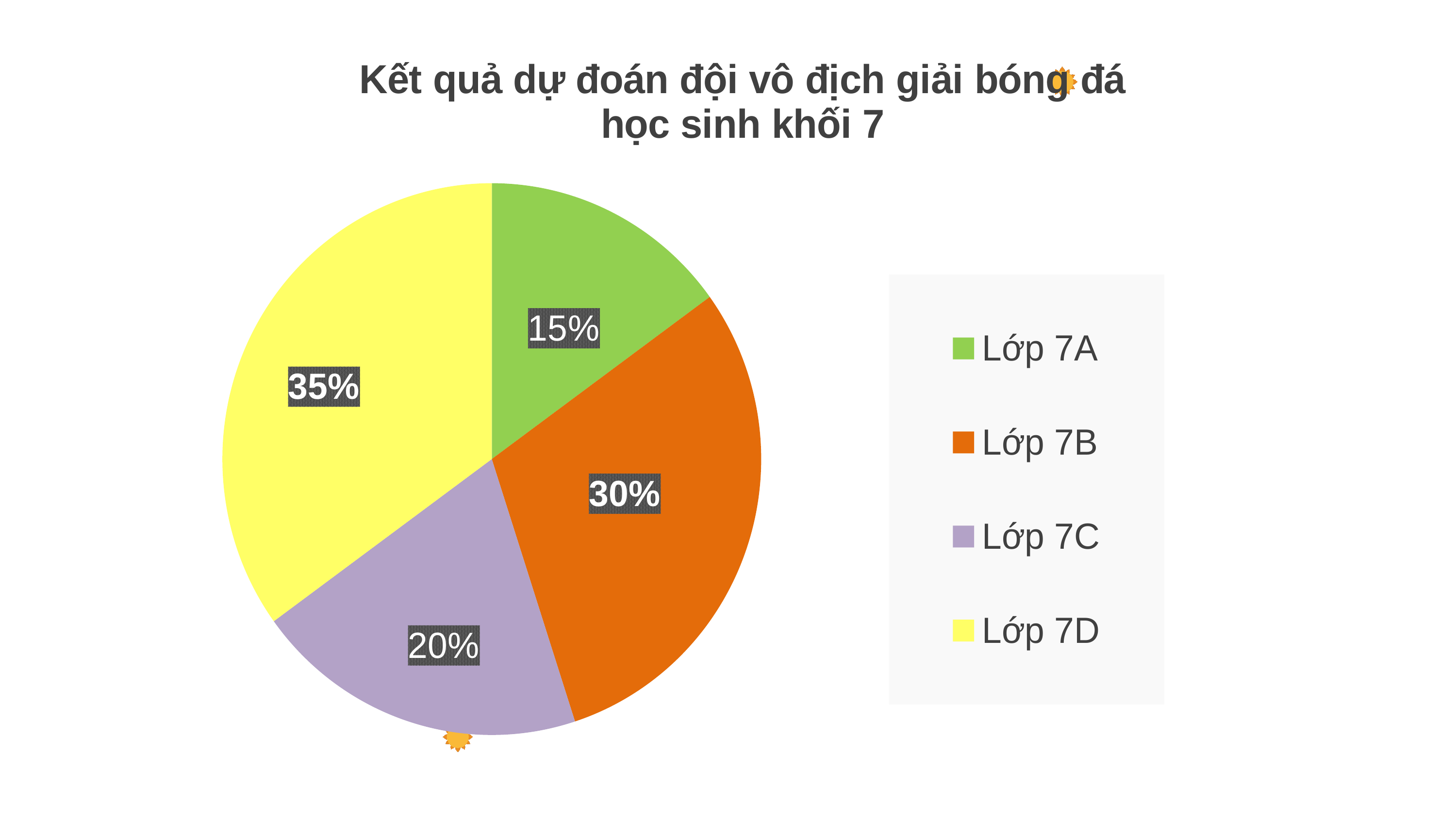
How many slices does the pie chart have? 4 Which colour represents Lớp 7D in the legend? Yellow What percentage of the pie does Lớp 7A account for? 15% What percentage of the pie does Lớp 7D account for? 35% What percentage of the pie does Lớp 7C account for? 20% Which has a larger share, Lớp 7B or Lớp 7C? Lớp 7B What percentage of the pie does Lớp 7B account for? 30% Which class has the smallest share of the pie? Lớp 7A What is the difference in percentage points between Lớp 7D and Lớp 7A? 20 What is the combined share of Lớp 7B and Lớp 7C? 50% Which class has the largest share of the pie? Lớp 7D What kind of chart is shown on the slide? Pie chart